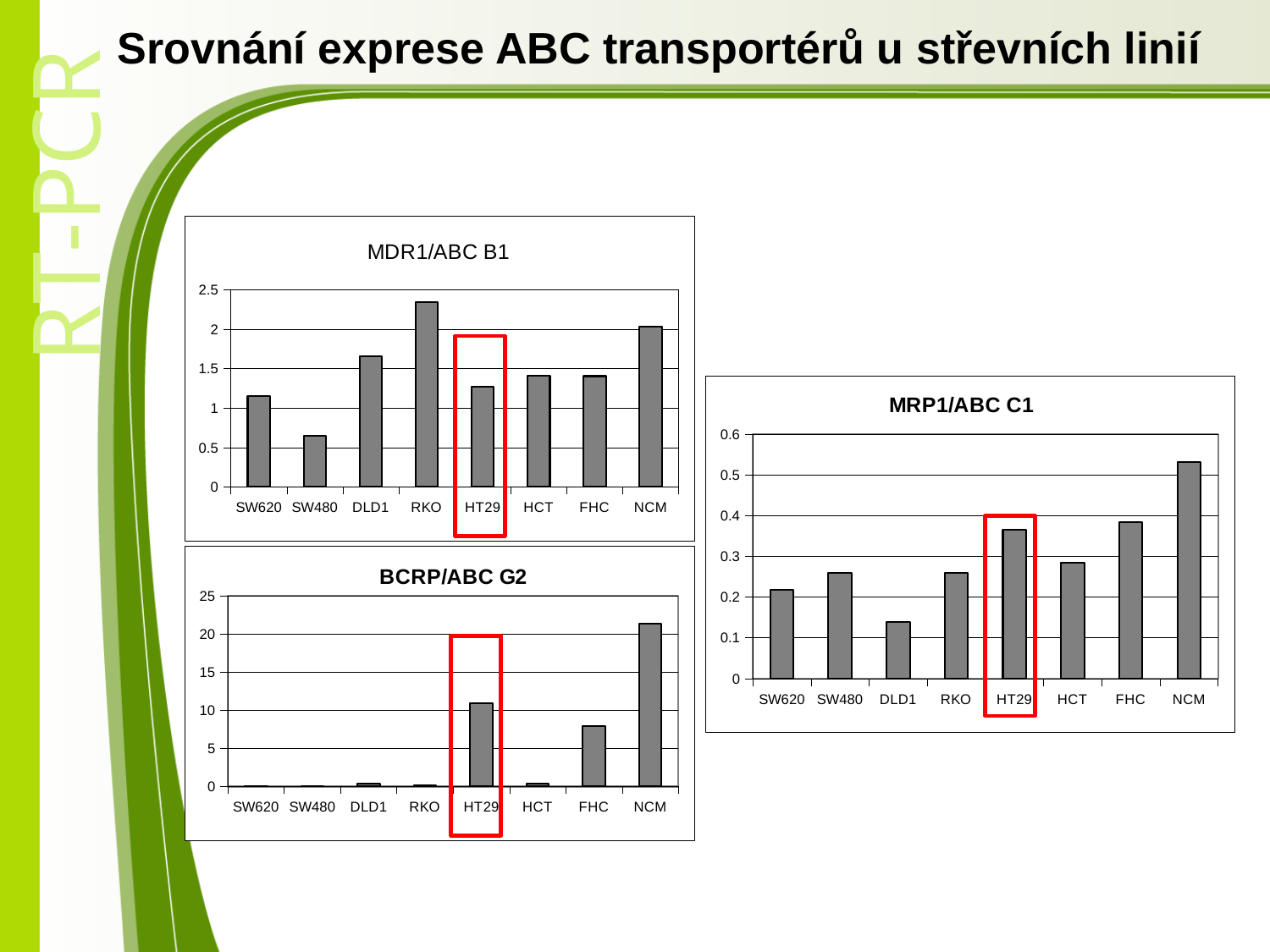
In the MRP1/ABC C1 chart, which cell line has the highest value? NCM In the MRP1/ABC C1 chart, is the value for NCM greater or less than 0.5? greater In the BCRP/ABC G2 chart, which is larger, the value for HT29 or the value for FHC? HT29 In the BCRP/ABC G2 chart, is the value for HT29 greater or less than 10? greater In the BCRP/ABC G2 chart, which cell line has the highest value? NCM In the MDR1/ABC B1 chart, is the value for RKO greater or less than 2? greater In the MDR1/ABC B1 chart, which cell line has the highest value? RKO What kind of chart is the BCRP/ABC G2 chart? bar chart In the MDR1/ABC B1 chart, which cell line has the lowest value? SW480 How many cell lines are shown on the x axis of the MRP1/ABC C1 chart? 8 In the MRP1/ABC C1 chart, which cell line has the lowest value? DLD1